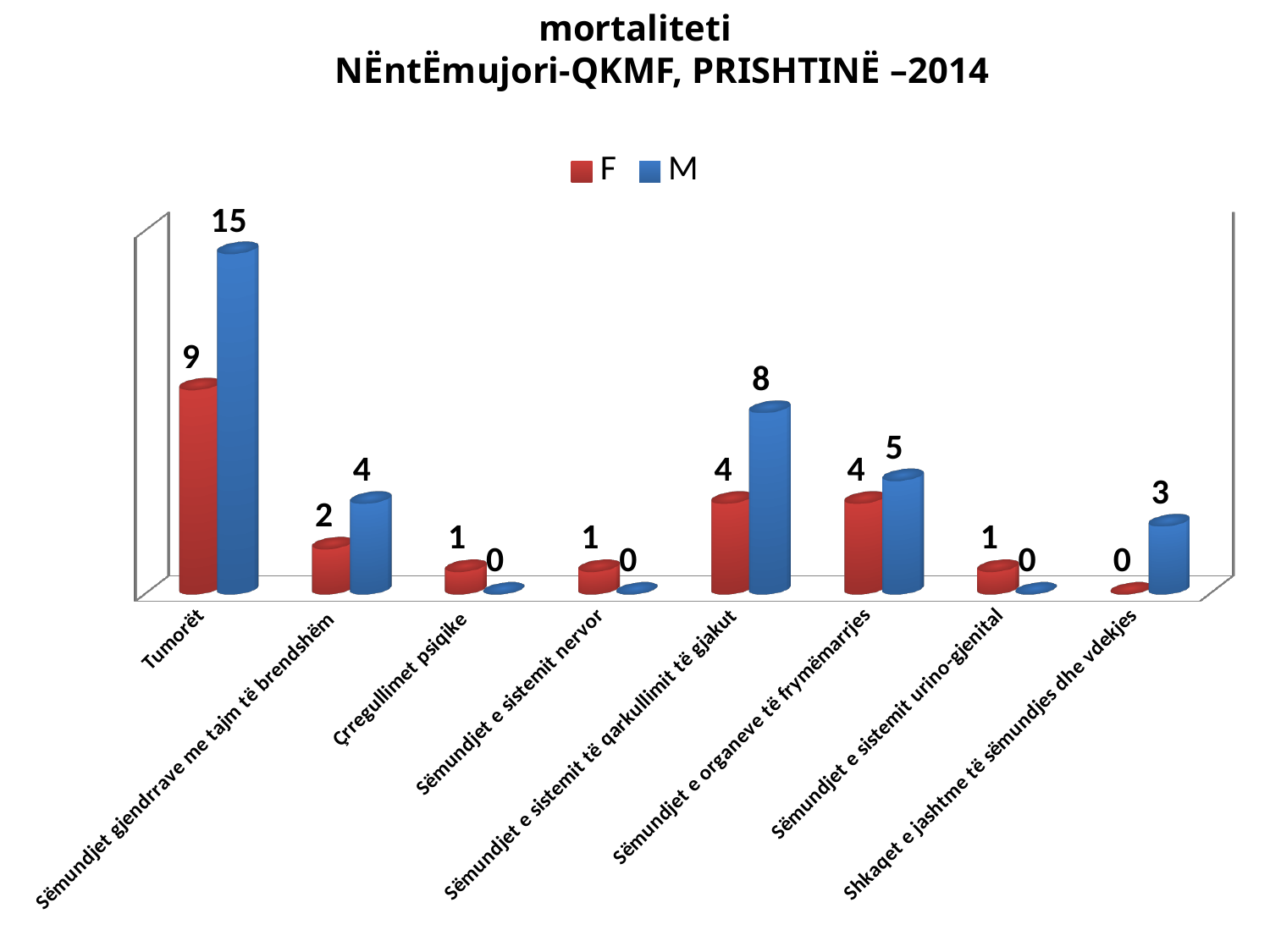
How many series does the legend list? 2 Which category has the lowest F value? Shkaqet e jashtme të sëmundjes dhe vdekjes What is the M value for Shkaqet e jashtme të sëmundjes dhe vdekjes? 3 For Sëmundjet e organeve të frymëmarrjes, which is larger, F or M? M What is the F value for Sëmundjet e sistemit të qarkullimit të gjakut? 4 What is the difference between the M and F values for Sëmundjet e sistemit të qarkullimit të gjakut? 4 Which category has the highest F value? Tumorët What is the M value for Tumorët? 15 What is the difference between the M and F values for Tumorët? 6 What is the F value for Sëmundjet e sistemit urino-gjenital? 1 How many categories are shown on the x axis? 8 What kind of chart is this? Bar chart